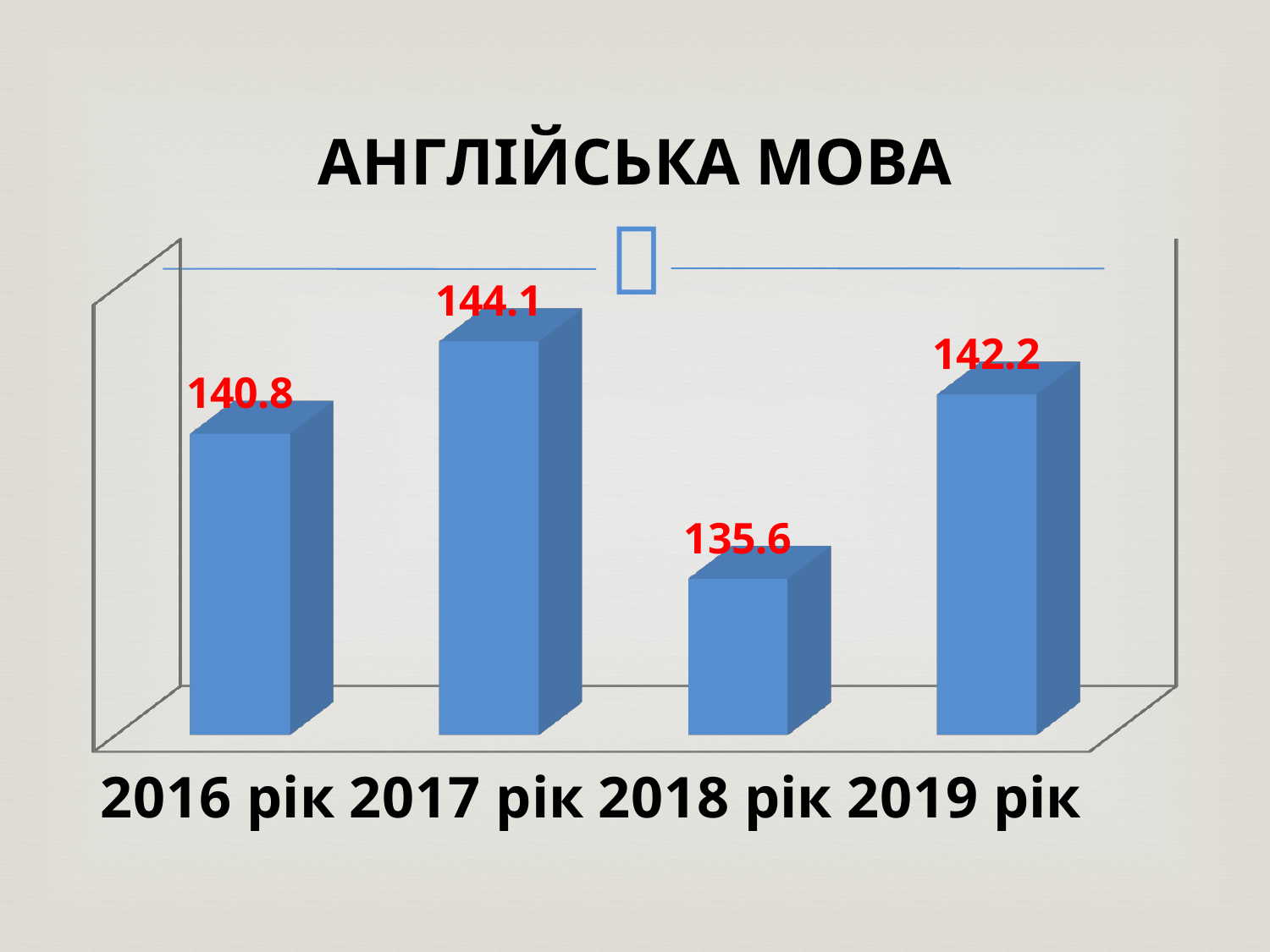
What is the difference between the values for 2019 рік and 2016 рік? 1.4 What is the title of the slide? АНГЛІЙСЬКА МОВА What is the value for 2018 рік? 135.6 Which year has the highest value? 2017 рік What is the difference between the values for 2017 рік and 2018 рік? 8.5 Which is larger, the value for 2016 рік or the value for 2019 рік? 2019 рік What kind of chart is shown on the slide? bar chart Which year has the lowest value? 2018 рік What is the value for 2016 рік? 140.8 How many years are shown on the chart? 4 What is the value for 2017 рік? 144.1 What is the value for 2019 рік? 142.2